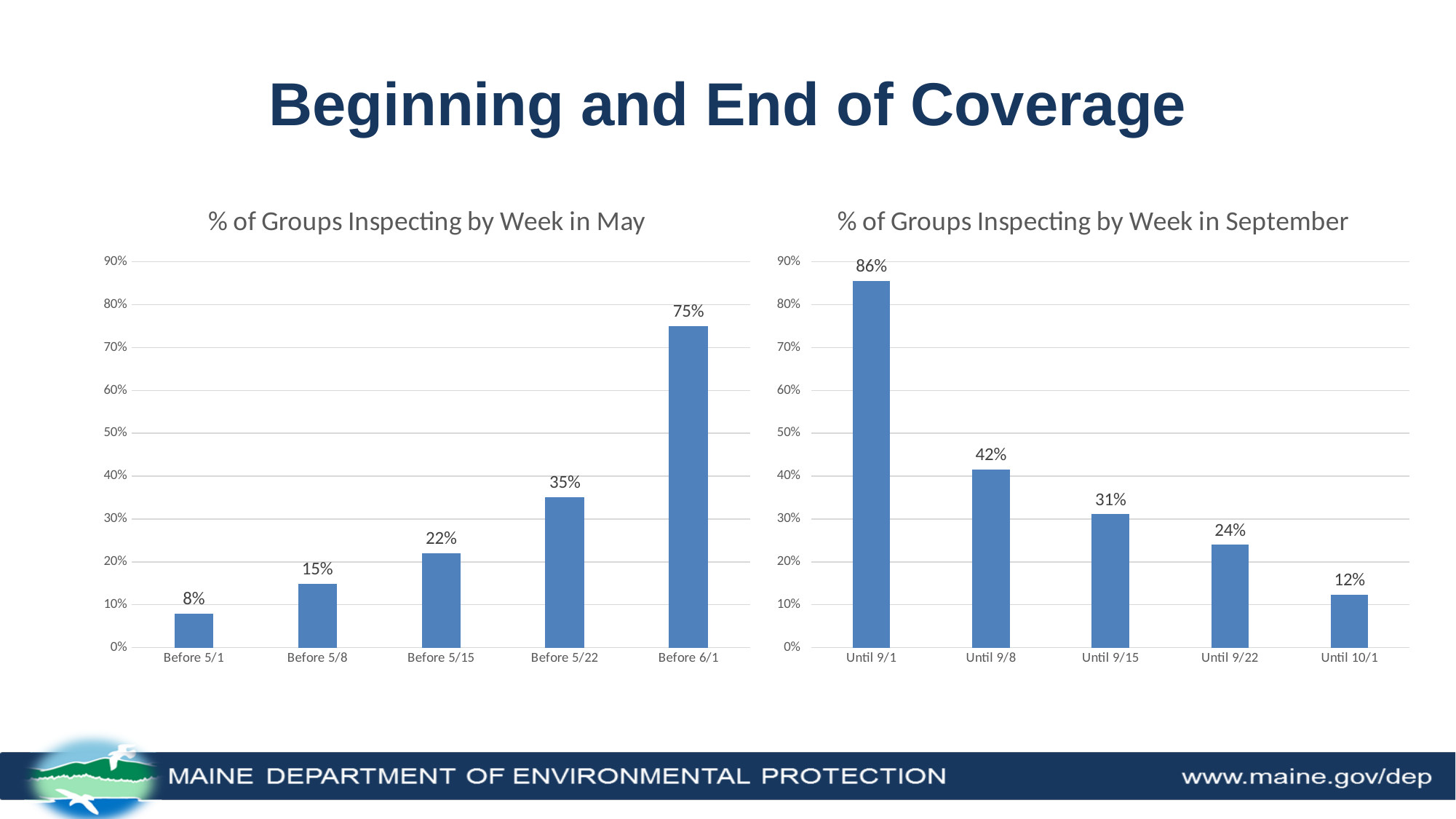
In the '% of Groups Inspecting by Week in September' chart, what is the value for Until 9/22? 24% In the '% of Groups Inspecting by Week in September' chart, which category has the lowest value? Until 10/1 What is the title of the chart on the left side of the slide? % of Groups Inspecting by Week in May What kind of chart is the '% of Groups Inspecting by Week in September' chart? bar chart In the '% of Groups Inspecting by Week in May' chart, which category has the highest value? Before 6/1 In the '% of Groups Inspecting by Week in May' chart, is the value for Before 5/22 greater or less than 30%? greater In the '% of Groups Inspecting by Week in September' chart, which is larger: the value for Until 9/8 or Until 9/15? Until 9/8 In the '% of Groups Inspecting by Week in September' chart, do the values rise or fall from left to right along the x axis? fall In the '% of Groups Inspecting by Week in May' chart, what is the difference between the values for Before 6/1 and Before 5/22? 40% In the '% of Groups Inspecting by Week in May' chart, what is the value for Before 5/15? 22% In the '% of Groups Inspecting by Week in September' chart, what is the difference between the values for Until 9/1 and Until 9/8? 44% How many categories are shown in the '% of Groups Inspecting by Week in May' chart? 5